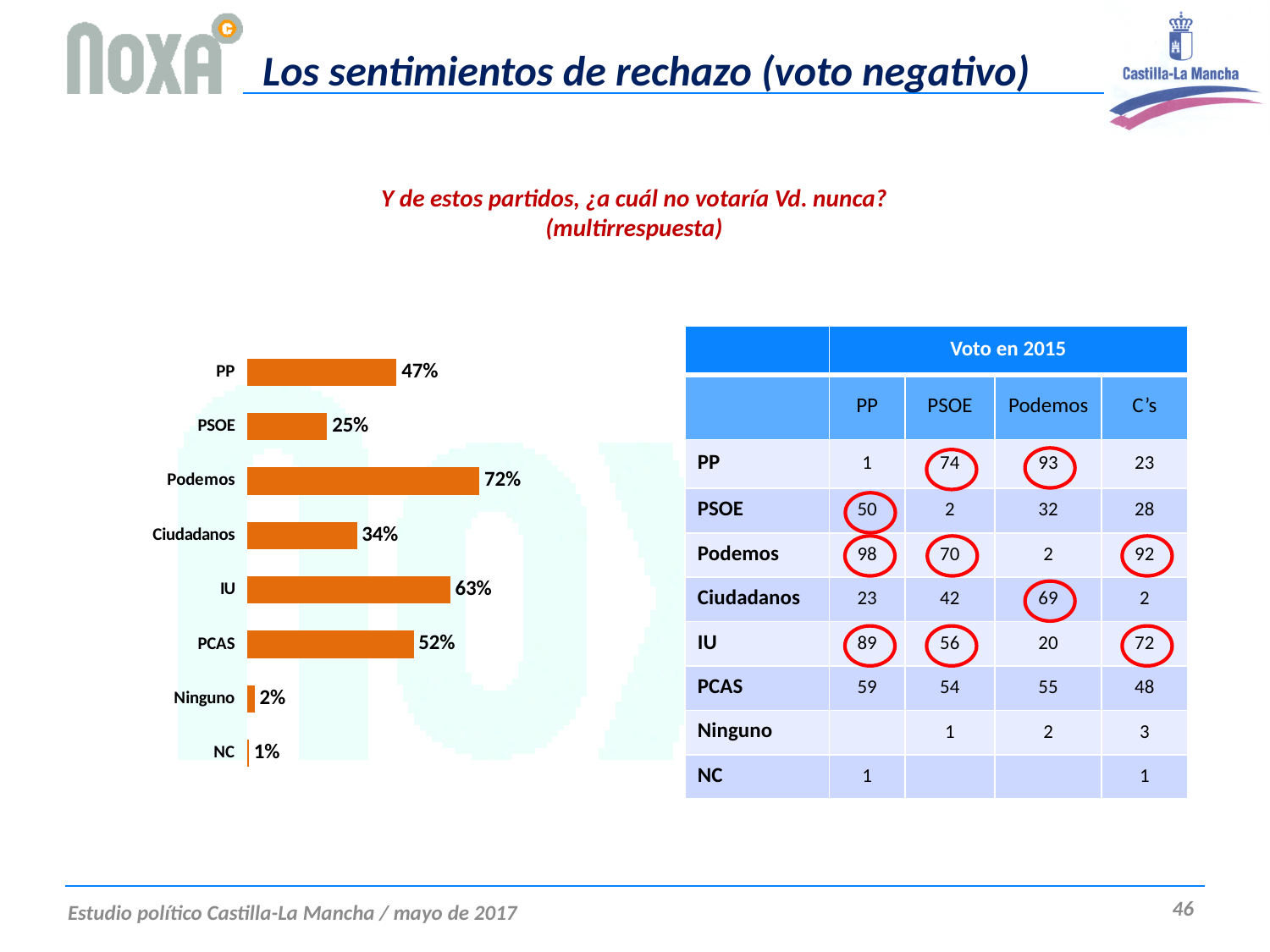
What is the value for IU in the bar chart? 63% What is the value for PP in the bar chart? 47% Which category has the lowest value in the bar chart? NC Which is larger in the bar chart, the value for PCAS or the value for Ciudadanos? PCAS Which category has the highest value in the bar chart? Podemos What is the value for Ninguno in the bar chart? 2% What kind of chart is shown on the slide? bar chart How many categories are shown in the bar chart? 8 What colour are the bars in the bar chart? orange What is the difference between the values for Podemos and PP in the bar chart? 25% What is the value for Podemos in the bar chart? 72% What is the difference between the values for IU and PSOE in the bar chart? 38%